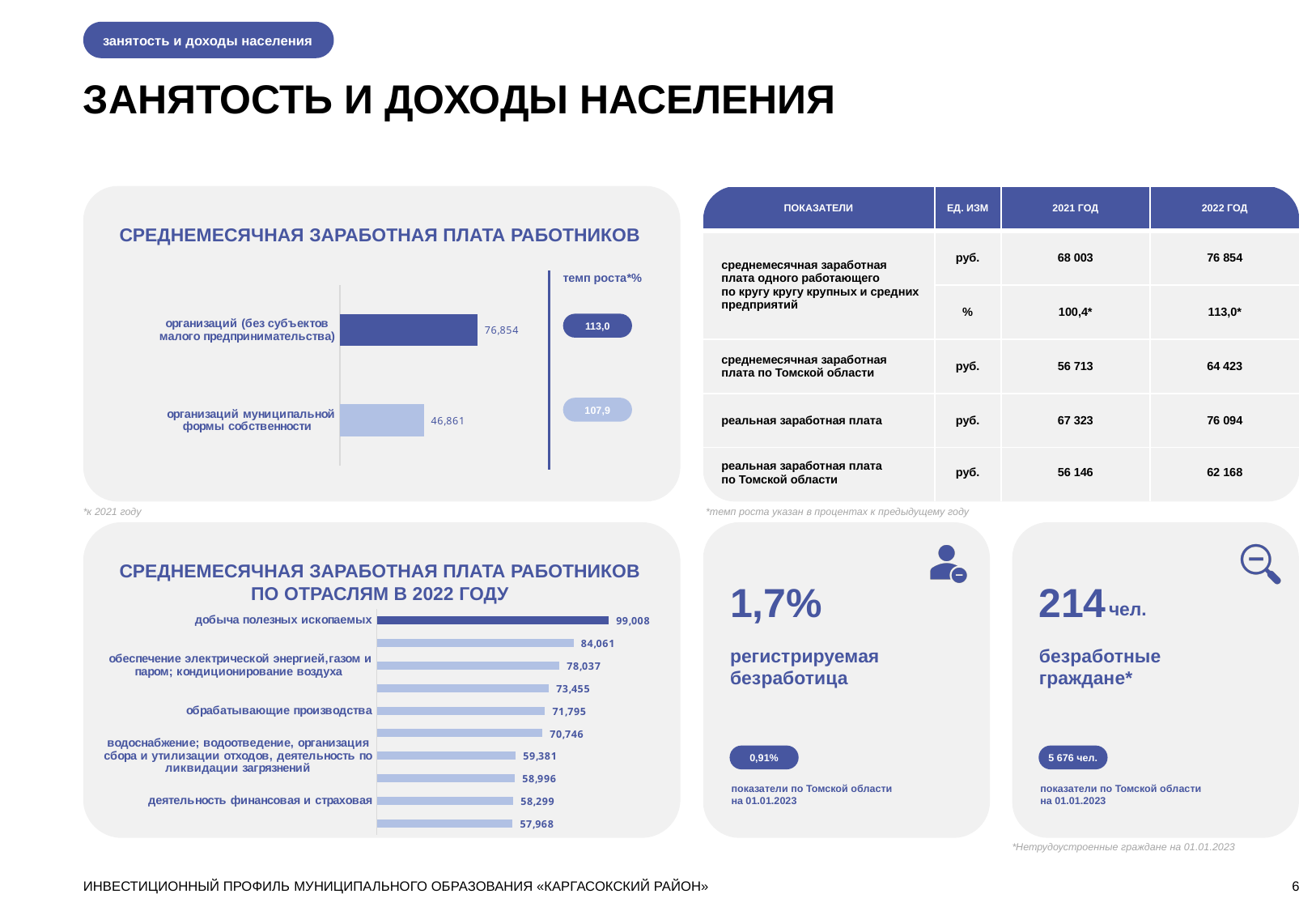
In the chart 'СРЕДНЕМЕСЯЧНАЯ ЗАРАБОТНАЯ ПЛАТА РАБОТНИКОВ', how many bars are plotted? 2 In the chart 'СРЕДНЕМЕСЯЧНАЯ ЗАРАБОТНАЯ ПЛАТА РАБОТНИКОВ ПО ОТРАСЛЯМ В 2022 ГОДУ', what is the value for 'добыча полезных ископаемых'? 99,008 In the chart 'СРЕДНЕМЕСЯЧНАЯ ЗАРАБОТНАЯ ПЛАТА РАБОТНИКОВ', what is the difference between the two bar values? 29,993 What kind of chart is 'СРЕДНЕМЕСЯЧНАЯ ЗАРАБОТНАЯ ПЛАТА РАБОТНИКОВ ПО ОТРАСЛЯМ В 2022 ГОДУ'? bar chart In the chart 'СРЕДНЕМЕСЯЧНАЯ ЗАРАБОТНАЯ ПЛАТА РАБОТНИКОВ ПО ОТРАСЛЯМ В 2022 ГОДУ', how many bars are plotted? 10 In the chart 'СРЕДНЕМЕСЯЧНАЯ ЗАРАБОТНАЯ ПЛАТА РАБОТНИКОВ ПО ОТРАСЛЯМ В 2022 ГОДУ', what is the value for 'обрабатывающие производства'? 71,795 In the chart 'СРЕДНЕМЕСЯЧНАЯ ЗАРАБОТНАЯ ПЛАТА РАБОТНИКОВ ПО ОТРАСЛЯМ В 2022 ГОДУ', which is larger: 'обрабатывающие производства' or 'деятельность финансовая и страховая'? обрабатывающие производства In the chart 'СРЕДНЕМЕСЯЧНАЯ ЗАРАБОТНАЯ ПЛАТА РАБОТНИКОВ ПО ОТРАСЛЯМ В 2022 ГОДУ', which industry has the highest value? добыча полезных ископаемых In the chart 'СРЕДНЕМЕСЯЧНАЯ ЗАРАБОТНАЯ ПЛАТА РАБОТНИКОВ ПО ОТРАСЛЯМ В 2022 ГОДУ', what is the value for 'деятельность финансовая и страховая'? 58,299 In the chart 'СРЕДНЕМЕСЯЧНАЯ ЗАРАБОТНАЯ ПЛАТА РАБОТНИКОВ', what is the 'темп роста' value shown for 'организаций муниципальной формы собственности'? 107,9 In the chart 'СРЕДНЕМЕСЯЧНАЯ ЗАРАБОТНАЯ ПЛАТА РАБОТНИКОВ', what is the value for 'организаций (без субъектов малого предпринимательства)'? 76,854 In the chart 'СРЕДНЕМЕСЯЧНАЯ ЗАРАБОТНАЯ ПЛАТА РАБОТНИКОВ', what is the value for 'организаций муниципальной формы собственности'? 46,861